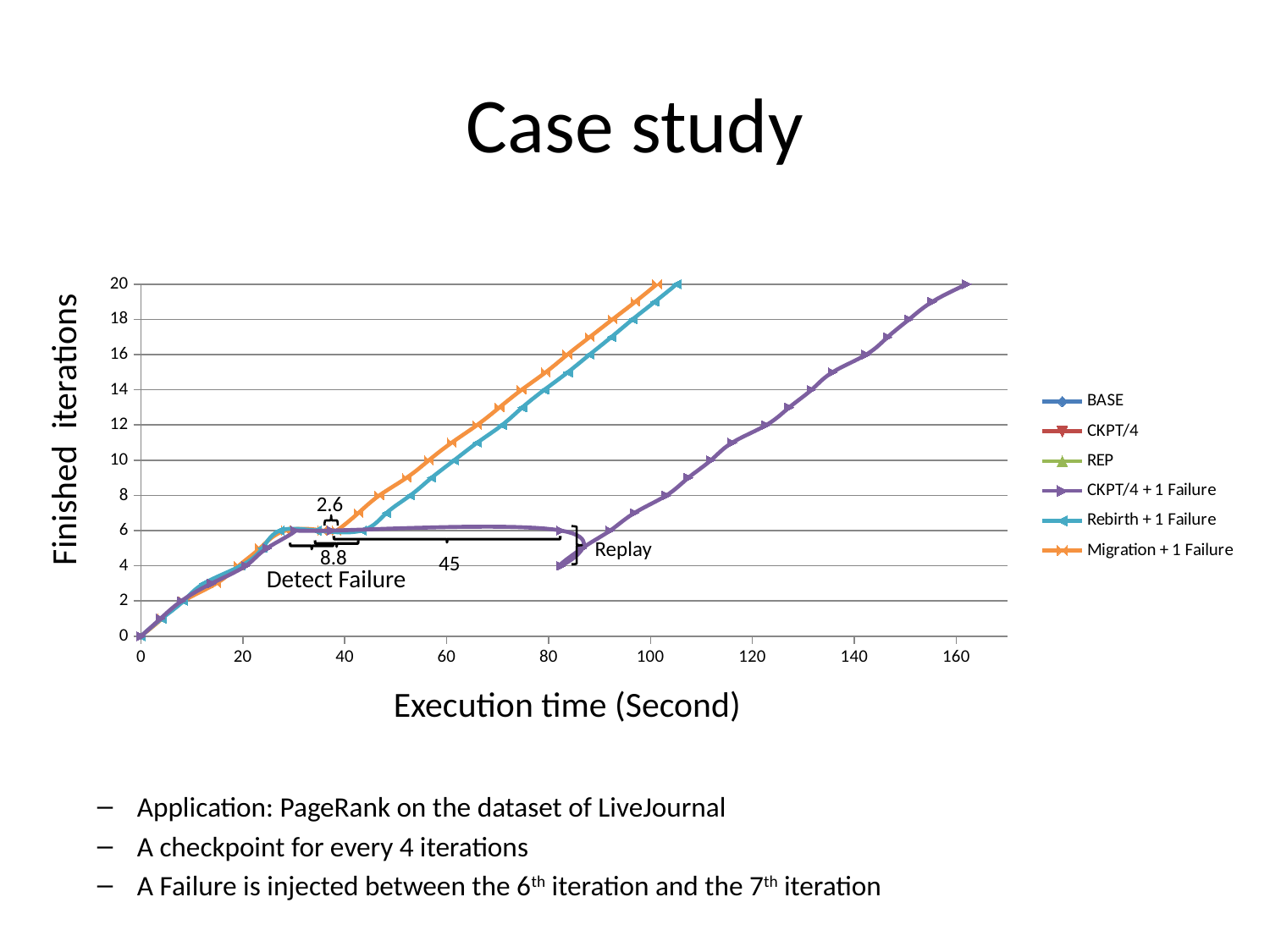
Which series takes the longest execution time to reach 20 finished iterations? CKPT/4 + 1 Failure What kind of chart is shown on the slide? line chart What is the smallest annotated time value shown near the failure point on the chart? 2.6 Is the execution time at which Rebirth + 1 Failure reaches 20 finished iterations greater or less than 120 seconds? less What is the label of the y axis? Finished iterations What value is annotated for the Detect Failure segment? 8.8 What is the label of the x axis? Execution time (Second) Which reaches 20 finished iterations earlier, Migration + 1 Failure or Rebirth + 1 Failure? Migration + 1 Failure How many series does the legend list? 6 Is the execution time at which CKPT/4 + 1 Failure reaches 20 finished iterations greater or less than 140 seconds? greater Do the finished iterations rise or fall as execution time increases for the Migration + 1 Failure series? rise